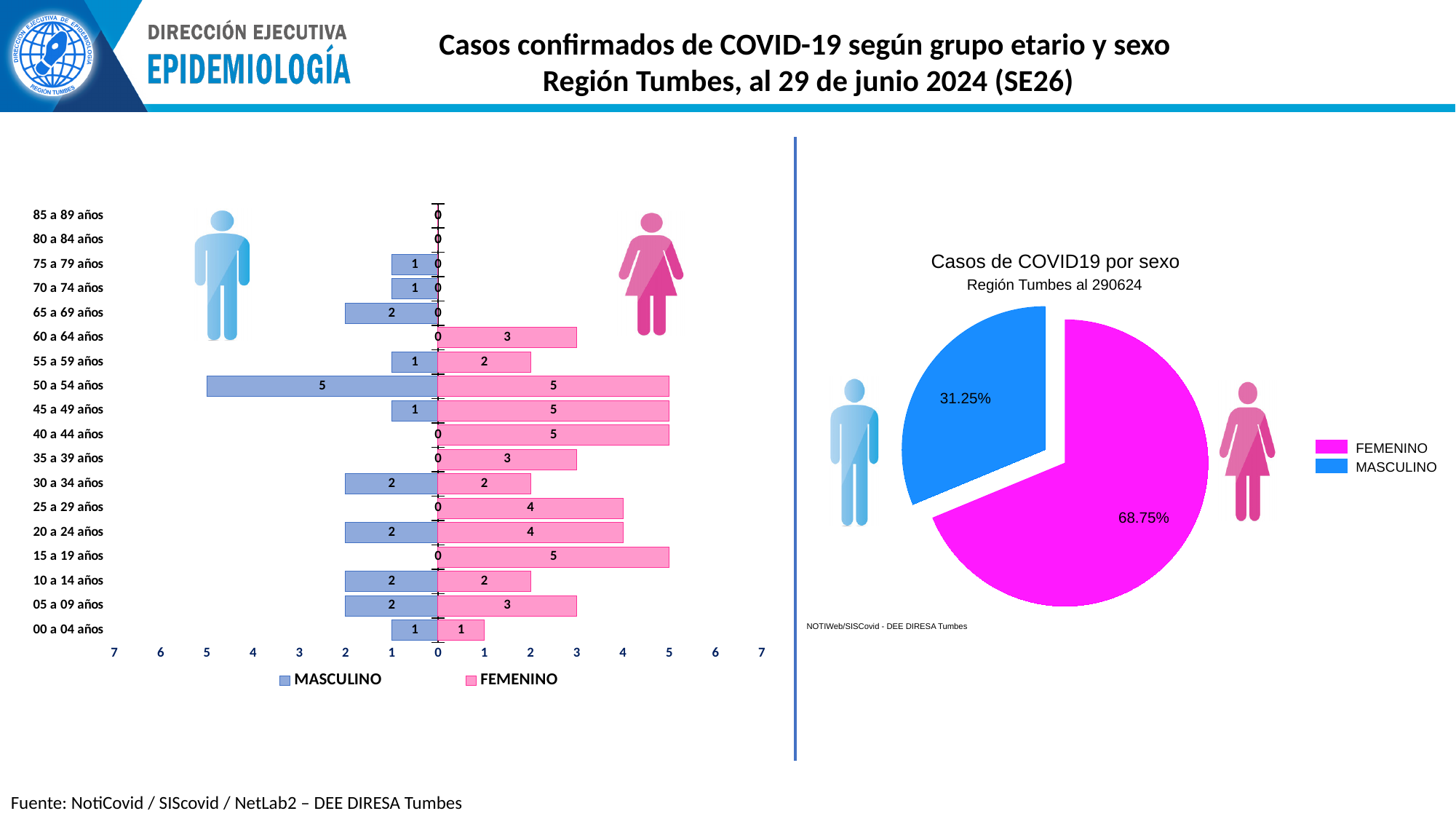
In the left chart (cases by age group and sex), how many FEMENINO cases are in the 25 a 29 años group? 4 In the left chart (cases by age group and sex), what is the difference between FEMENINO and MASCULINO cases in the 45 a 49 años group? 4 In the pie chart 'Casos de COVID19 por sexo', what share is MASCULINO? 31.25% In the pie chart 'Casos de COVID19 por sexo', what share is FEMENINO? 68.75% In the pie chart 'Casos de COVID19 por sexo', which colour represents MASCULINO? Blue What type of chart is the left chart showing cases by age group and sex? Bar chart In the left chart (cases by age group and sex), which is larger in the 20 a 24 años group, MASCULINO or FEMENINO? FEMENINO In the left chart (cases by age group and sex), how many age groups are shown on the vertical axis? 18 In the left chart (cases by age group and sex), how many series does the legend list? 2 In the left chart (cases by age group and sex), which age group has the highest MASCULINO value? 50 a 54 años In the left chart (cases by age group and sex), how many FEMENINO cases are in the 65 a 69 años group? 0 In the left chart (cases by age group and sex), how many MASCULINO cases are in the 50 a 54 años group? 5